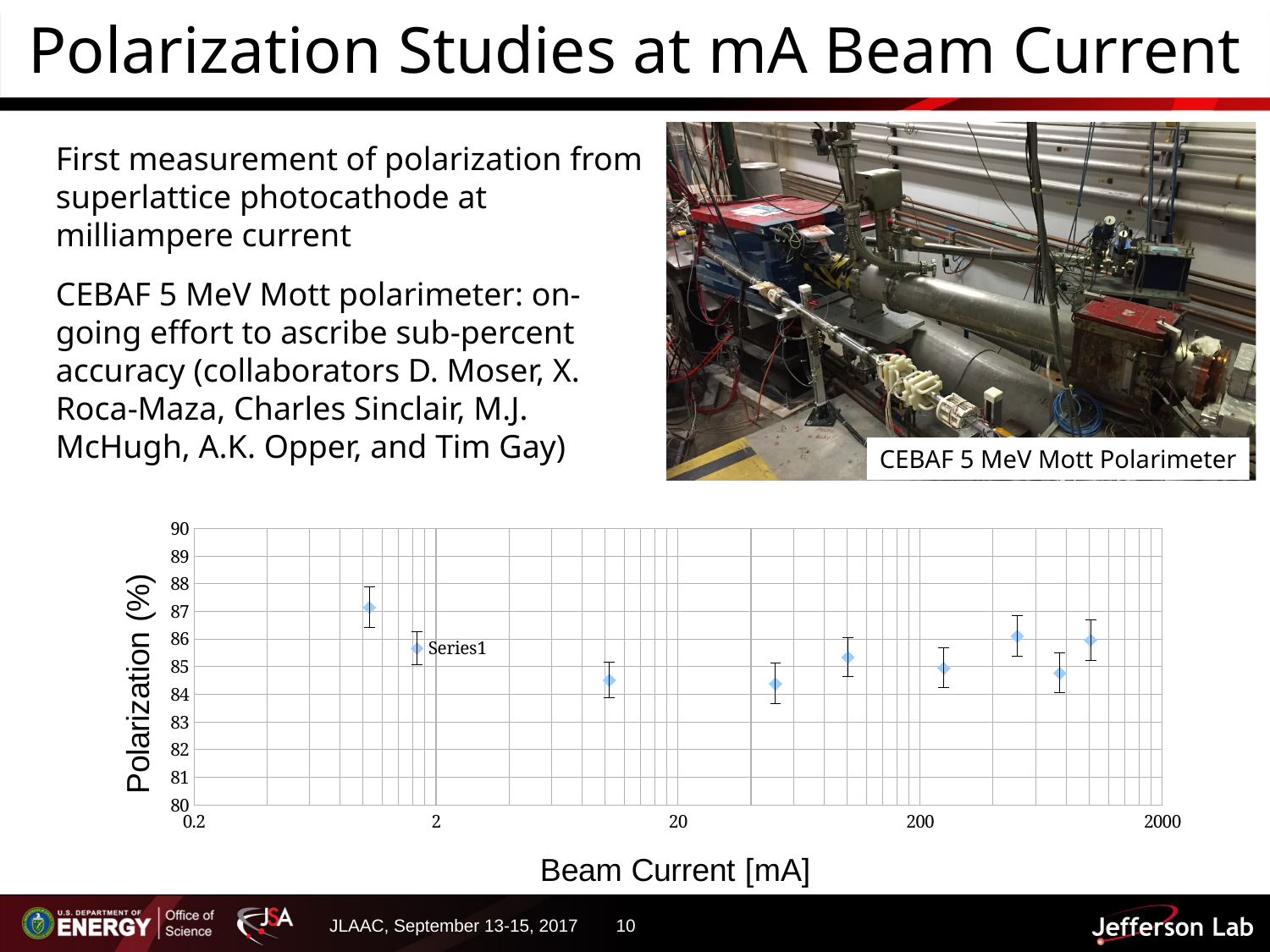
Is the polarization value of the rightmost data point greater or less than 85? greater Which is larger, the polarization of the leftmost data point or the polarization of the rightmost data point? the leftmost data point What is the label of the x axis of the chart? Beam Current [mA] Is the polarization value of the data point near 500 mA greater or less than 85? greater How many data points are plotted in the chart? 9 Is the polarization value of the data point just below 20 mA greater or less than 85? less What is the highest value shown on the y axis of the chart? 90 Which data point has the highest polarization value? the leftmost point (lowest beam current, near 1 mA) What kind of chart is shown on the slide? scatter plot What is the label of the y axis of the chart? Polarization (%) How many series does the chart show? 1